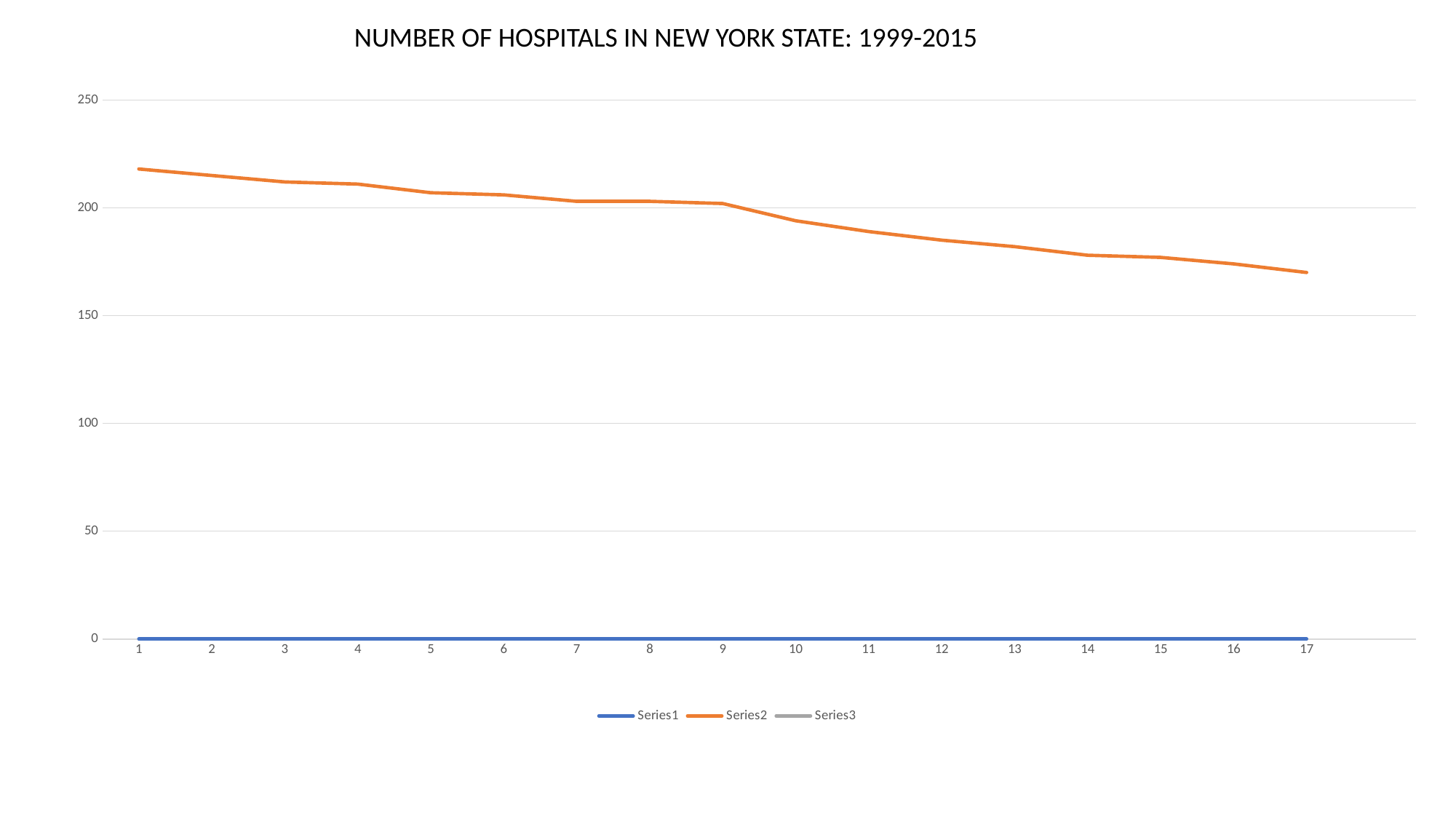
How many series does the legend list? 3 Is the value of Series2 at point 17 greater or less than 150? greater Is the value of Series2 at point 17 greater or less than 200? less What value does the Series1 line sit at across the chart? 0 Is the value of Series2 at point 1 greater or less than 200? greater At which x-axis point is Series2 lowest? 17 How many points are plotted along the x axis? 17 What kind of chart is shown on the slide? line chart What is the title of the chart? NUMBER OF HOSPITALS IN NEW YORK STATE: 1999-2015 Which is larger, the value of Series2 at point 1 or at point 17? point 1 At which x-axis point is Series2 highest? 1 Does the Series2 line rise or fall from point 1 to point 17? fall